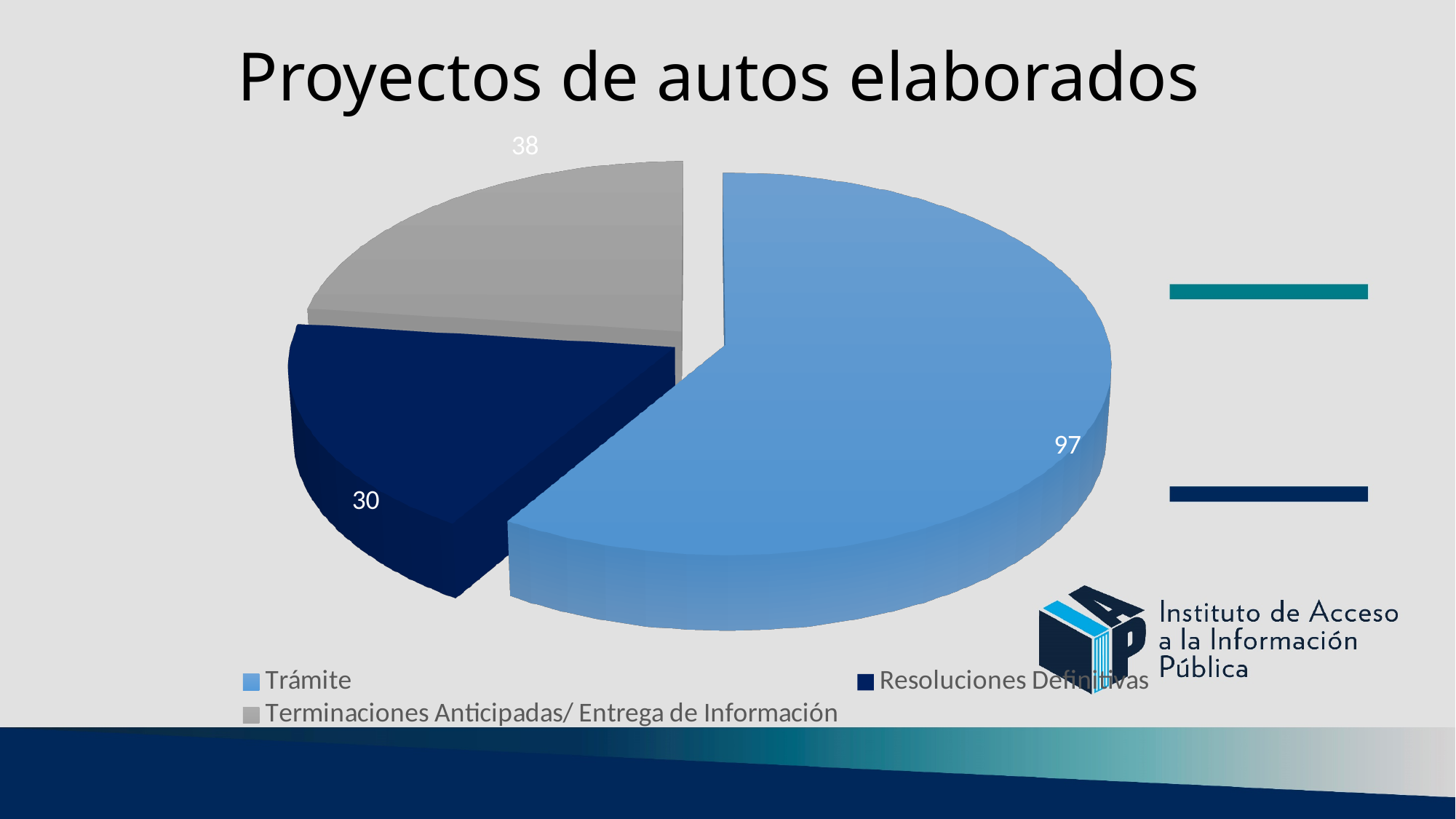
What is the value for Trámite? 97 How many categories does the pie chart show? 3 What is the difference between the values for Terminaciones Anticipadas/ Entrega de Información and Resoluciones Definitivas? 8 What is the value for Terminaciones Anticipadas/ Entrega de Información? 38 Which category has the largest slice? Trámite What is the title of the chart? Proyectos de autos elaborados What is the value for Resoluciones Definitivas? 30 Which is larger, Terminaciones Anticipadas/ Entrega de Información or Resoluciones Definitivas? Terminaciones Anticipadas/ Entrega de Información What is the difference between the values for Trámite and Resoluciones Definitivas? 67 What is the total of all slices in the pie chart? 165 Which category has the smallest slice? Resoluciones Definitivas What kind of chart is shown on the slide? Pie chart